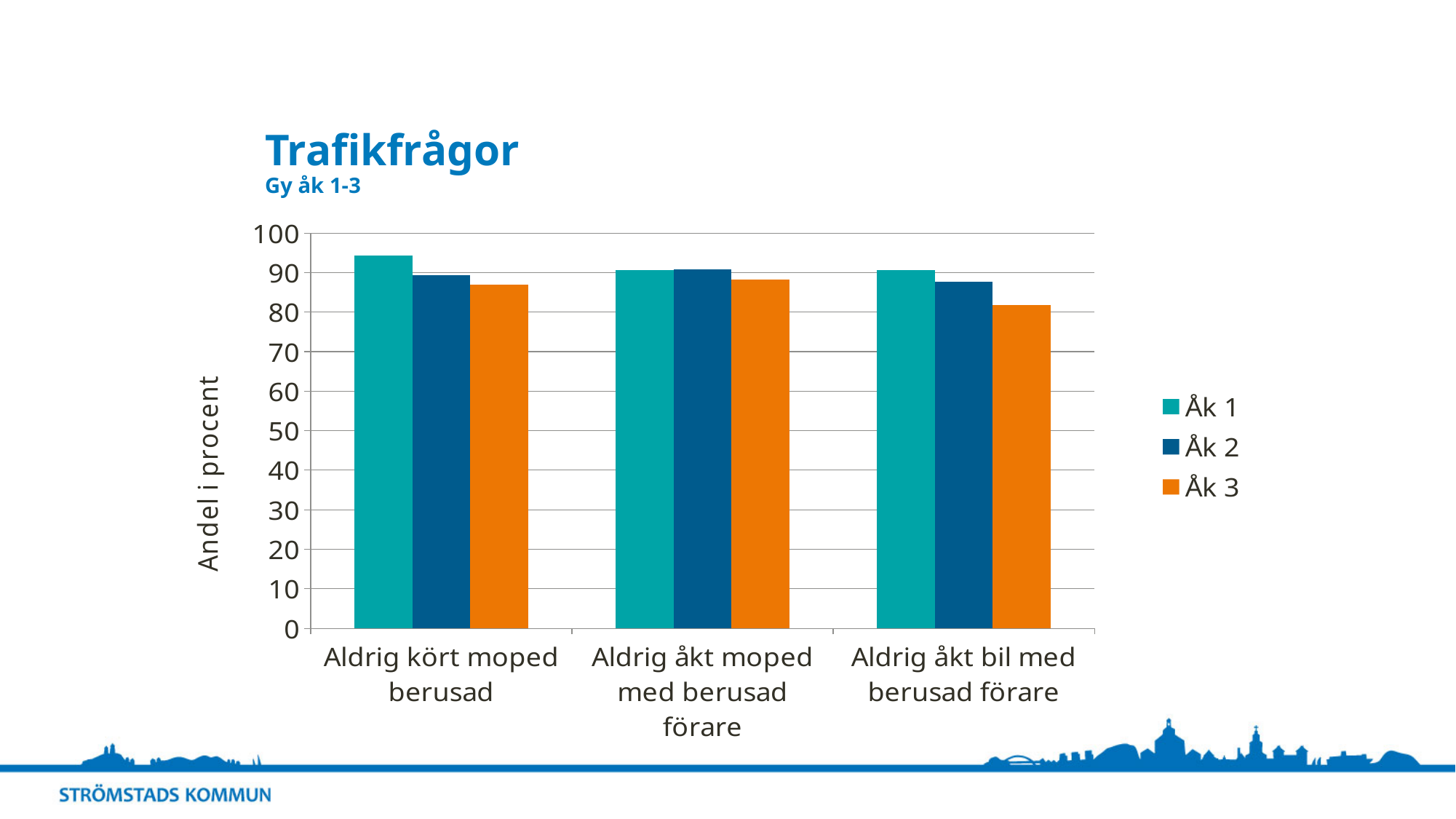
How many series does the legend list? 3 In 'Aldrig kört moped berusad', which series has the highest value? Åk 1 Is the value for Åk 3 in 'Aldrig kört moped berusad' greater or less than 90? less How many categories are shown on the x axis of the chart? 3 Is the value for Åk 2 in 'Aldrig åkt bil med berusad förare' greater or less than 80? greater What kind of chart is shown on the slide? bar chart In 'Aldrig åkt bil med berusad förare', which series has the lowest value? Åk 3 Is the value for Åk 3 in 'Aldrig åkt bil med berusad förare' greater or less than 90? less In 'Aldrig kört moped berusad', which is larger, the value for Åk 1 or the value for Åk 3? Åk 1 What is the label of the vertical axis? Andel i procent What is the title of the chart? Trafikfrågor